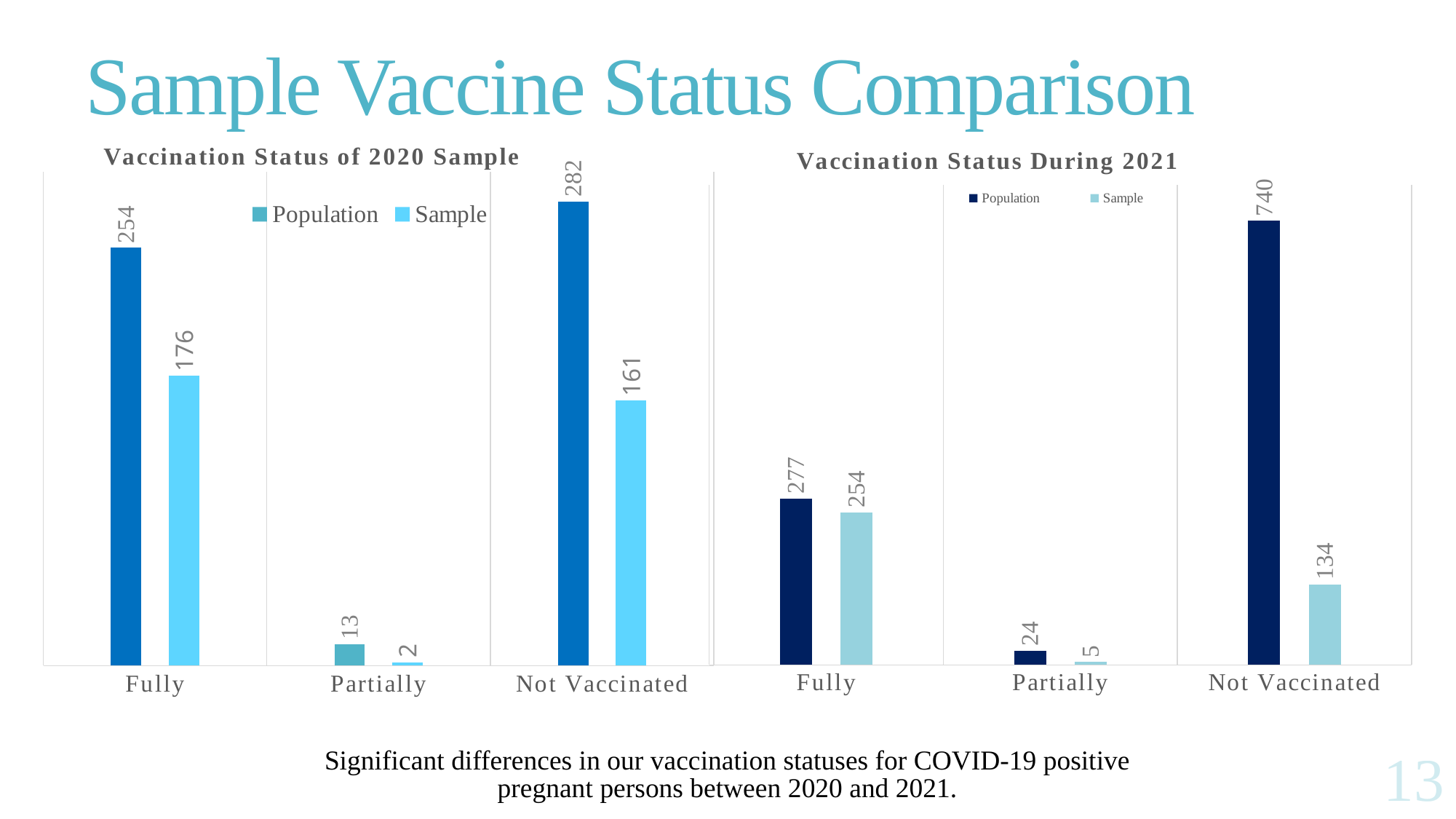
In the 'Vaccination Status During 2021' chart, which is larger for Fully vaccinated: the Population value or the Sample value? Population In the 'Vaccination Status of 2020 Sample' chart, what is the Population value for Fully vaccinated? 254 In the 'Vaccination Status During 2021' chart, what is the Sample value for Partially vaccinated? 5 In the 'Vaccination Status of 2020 Sample' chart, what is the Sample value for Not Vaccinated? 161 In the 'Vaccination Status of 2020 Sample' chart, which category has the lowest Sample value? Partially In the 'Vaccination Status During 2021' chart, what is the difference between the Population and Sample values for Not Vaccinated? 606 What type of chart is the 'Vaccination Status of 2020 Sample' chart? Bar chart In the 'Vaccination Status During 2021' chart, which category has the highest Population value? Not Vaccinated How many series does the legend of the 'Vaccination Status During 2021' chart list? 2 In the 'Vaccination Status During 2021' chart, what is the Population value for Not Vaccinated? 740 How many categories are shown on the x axis of the 'Vaccination Status of 2020 Sample' chart? 3 In the 'Vaccination Status of 2020 Sample' chart, what is the difference between the Population and Sample values for Fully vaccinated? 78